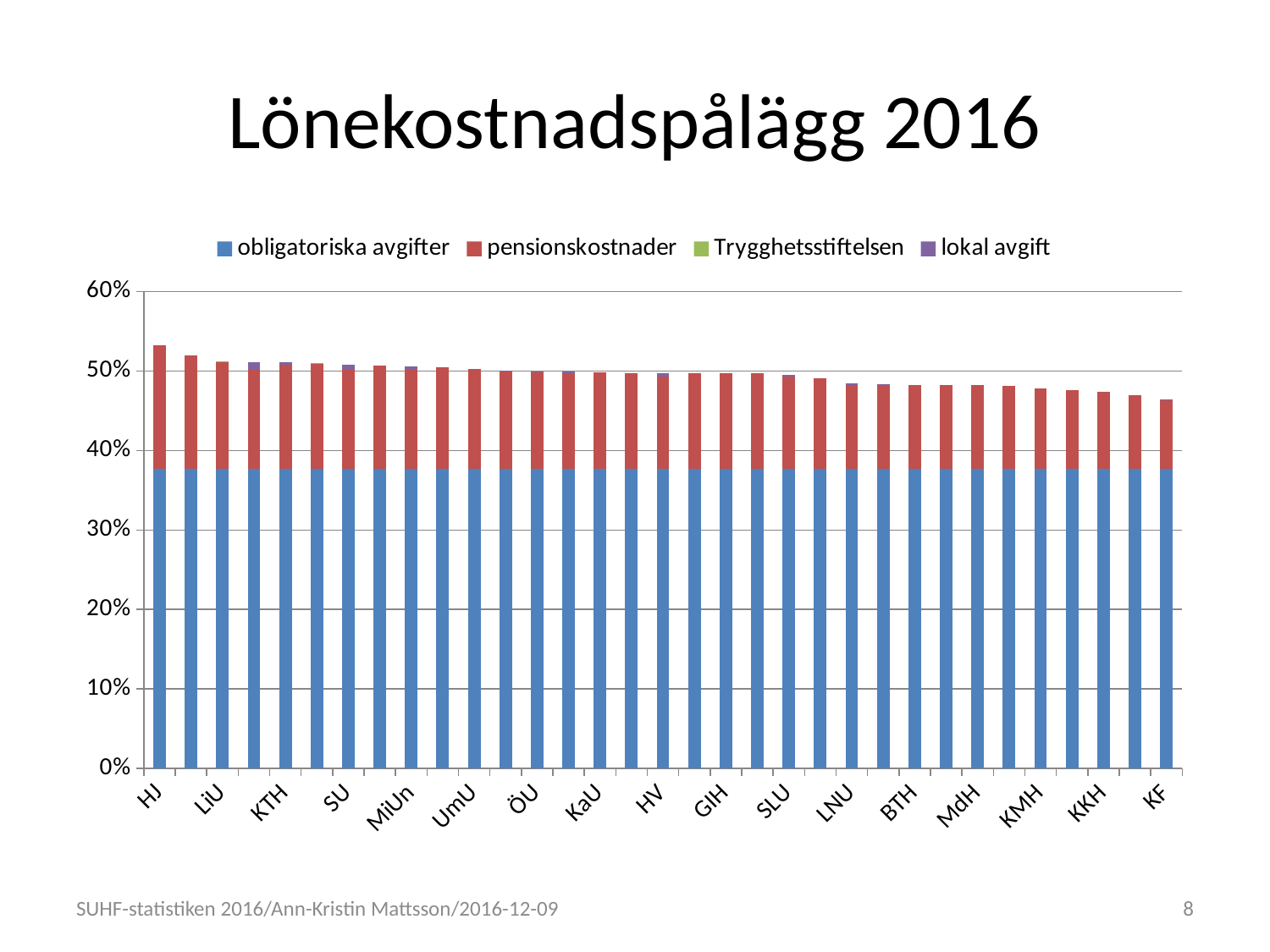
How many series does the legend list? 4 Do the total bar heights rise or fall from left to right along the x axis? fall Which series is shown in blue in the legend? obligatoriska avgifter What kind of chart is shown on the slide? stacked bar chart Is the obligatoriska avgifter value for HJ greater or less than 40%? less Is the total value for LNU greater or less than 50%? less What is the title of the chart? Lönekostnadspålägg 2016 Which category has the highest total bar? HJ Is the total value for HJ greater or less than 50%? greater Which has the larger total bar, HJ or KF? HJ Which category has the lowest total bar? KF